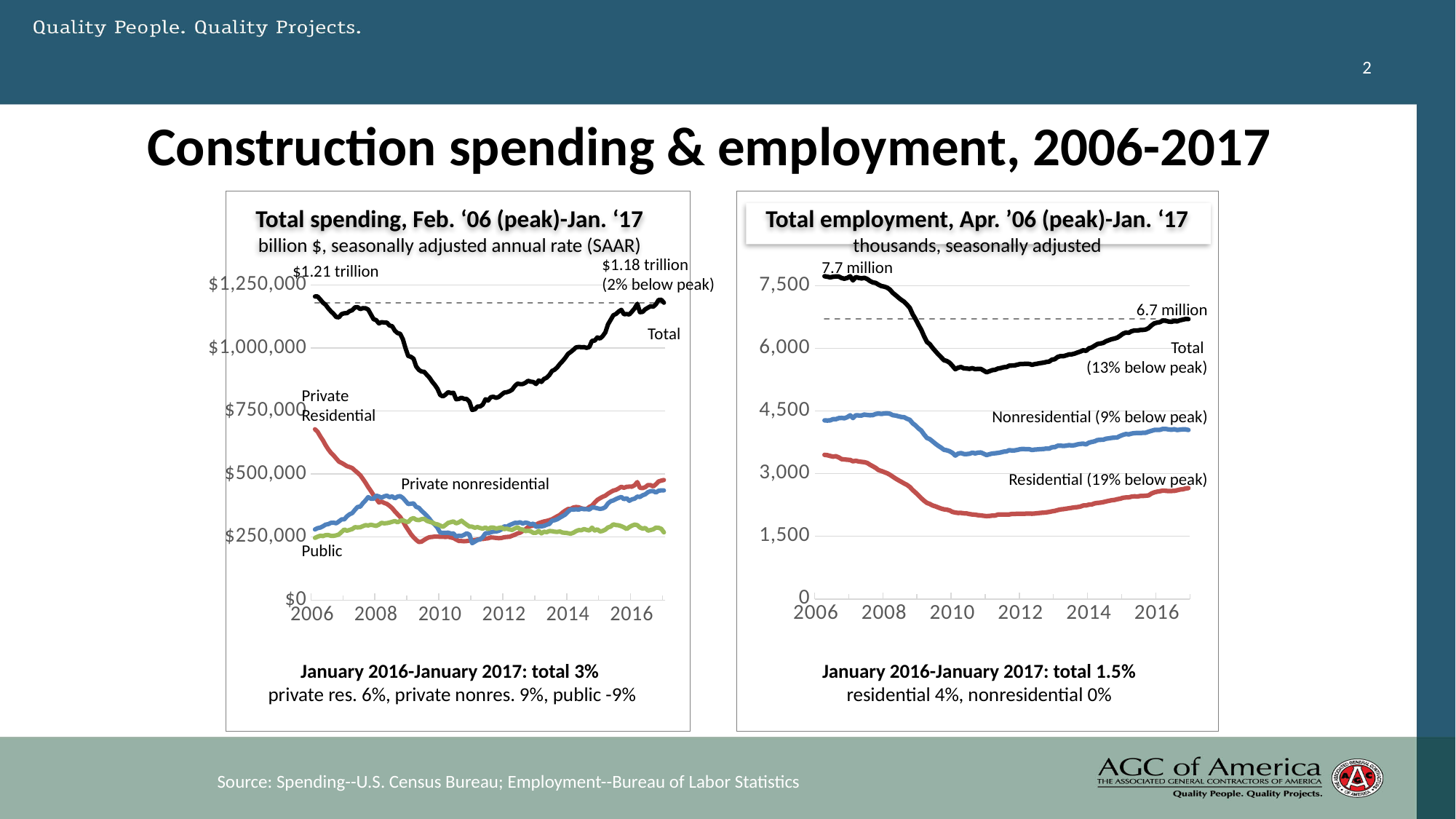
On the 'Total spending' chart, how many series are plotted? 5 On the 'Total employment' chart, what was the peak total employment in Apr. 2006? 7.7 million On the 'Total employment' chart, what was total employment in Jan. 2017? 6.7 million On the 'Total employment' chart, in 2016 which was higher, Nonresidential or Residential employment? Nonresidential On the 'Total spending' chart, what was the peak value of total spending in Feb. 2006? $1.21 trillion On the 'Total spending' chart, in 2006 which was higher, Private Residential or Public spending? Private Residential On the 'Total employment' chart, how far below its peak is Residential employment? 19% below peak What kind of chart is the 'Total spending' chart on the left? line chart On the 'Total spending' chart, what was total spending in Jan. 2017? $1.18 trillion On the 'Total employment' chart, was total employment in 2011 greater or less than 6,000? less On the 'Total spending' chart, was total spending in 2011 greater or less than $1,000,000? less On the 'Total spending' chart, did total spending rise or fall between 2006 and 2011? fall